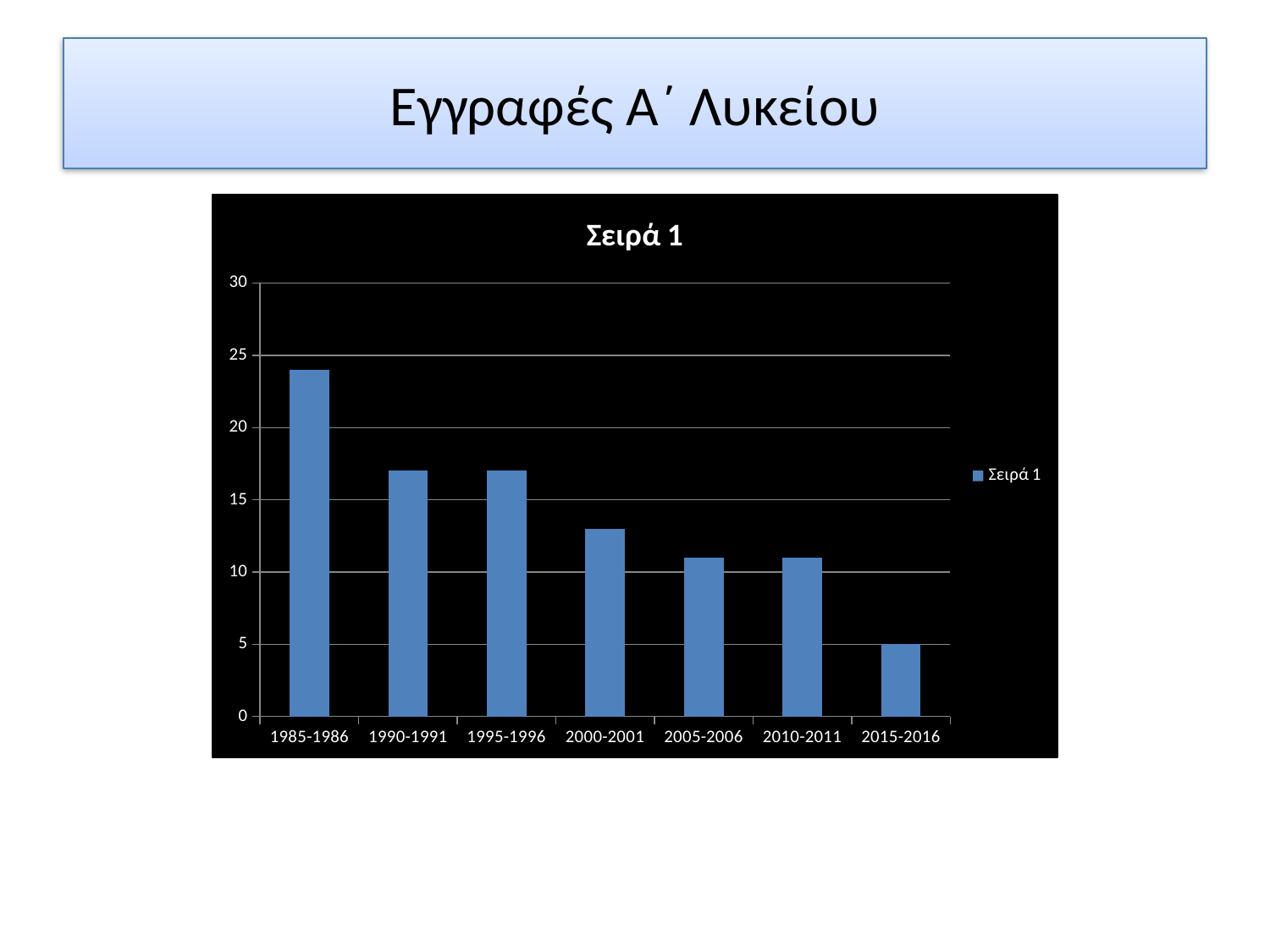
What is the title shown above the chart? Σειρά 1 What type of chart is shown on the slide? Bar chart Is the value for 2005-2006 greater or less than 10? greater Is the value for 1985-1986 greater or less than 20? greater Which school year has the lowest value? 2015-2016 Is the value for 2000-2001 greater or less than 15? less How many categories (school years) are shown on the x axis? 7 Which is larger, the value for 1985-1986 or the value for 2000-2001? 1985-1986 Do the values generally rise or fall from 1985-1986 to 2015-2016? Fall Which school year has the highest value? 1985-1986 How many series does the legend list? 1 What is the value for 2015-2016? 5